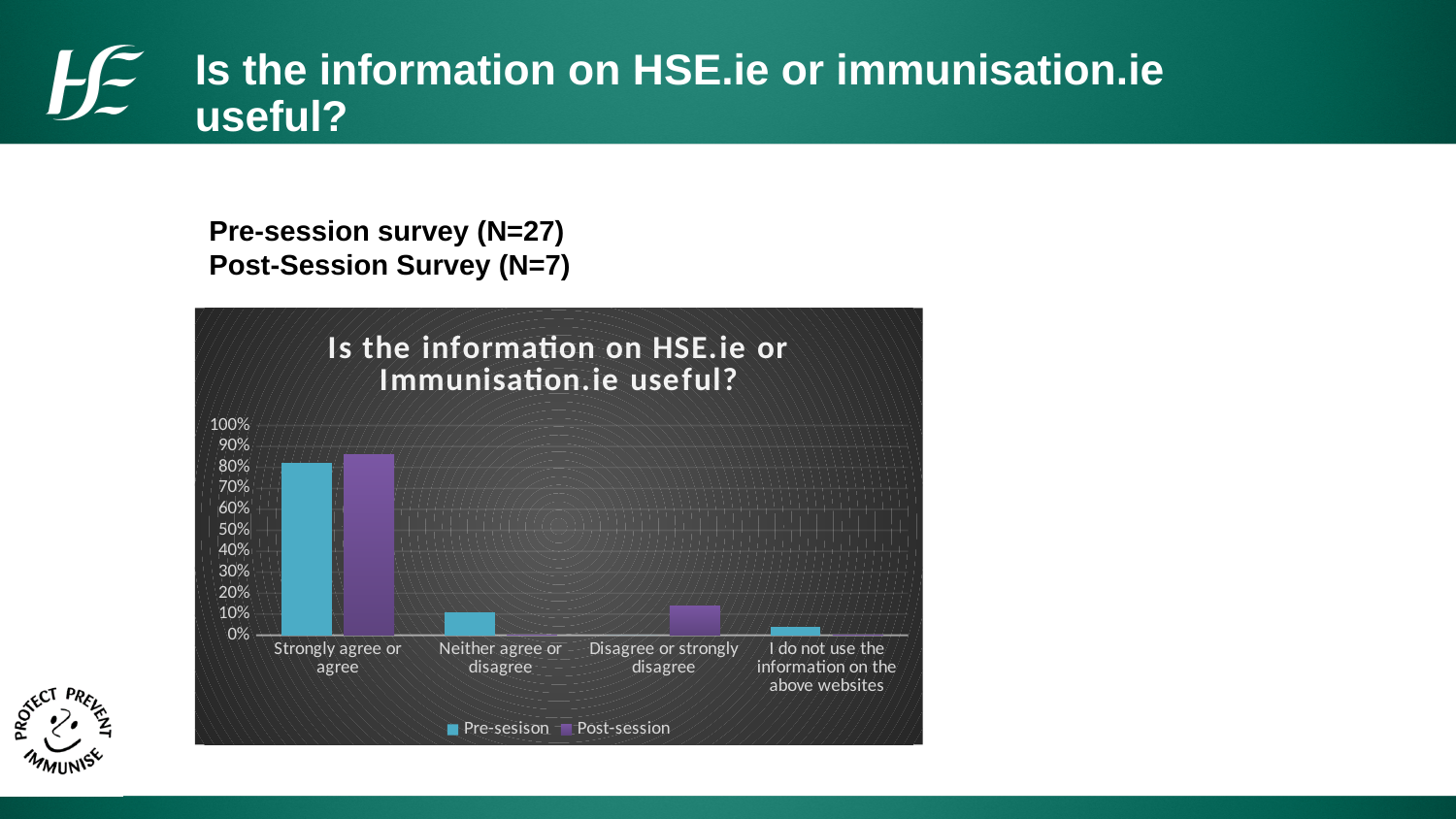
Which category has the highest Pre-session value? Strongly agree or agree For 'Strongly agree or agree', which series has the larger value, Pre-session or Post-session? Post-session Which category has the highest Post-session value? Strongly agree or agree Is the Pre-session value for 'Neither agree or disagree' greater or less than 20%? less Is the Pre-session value for 'Strongly agree or agree' greater or less than 70%? greater How many series does the chart legend list? 2 How many categories are shown along the x axis of the chart? 4 Is the Post-session value for 'Strongly agree or agree' greater or less than 90%? less What is the title of the chart? Is the information on HSE.ie or Immunisation.ie useful? What kind of chart is shown on the slide? bar chart For 'Neither agree or disagree', which series has the larger value, Pre-session or Post-session? Pre-session